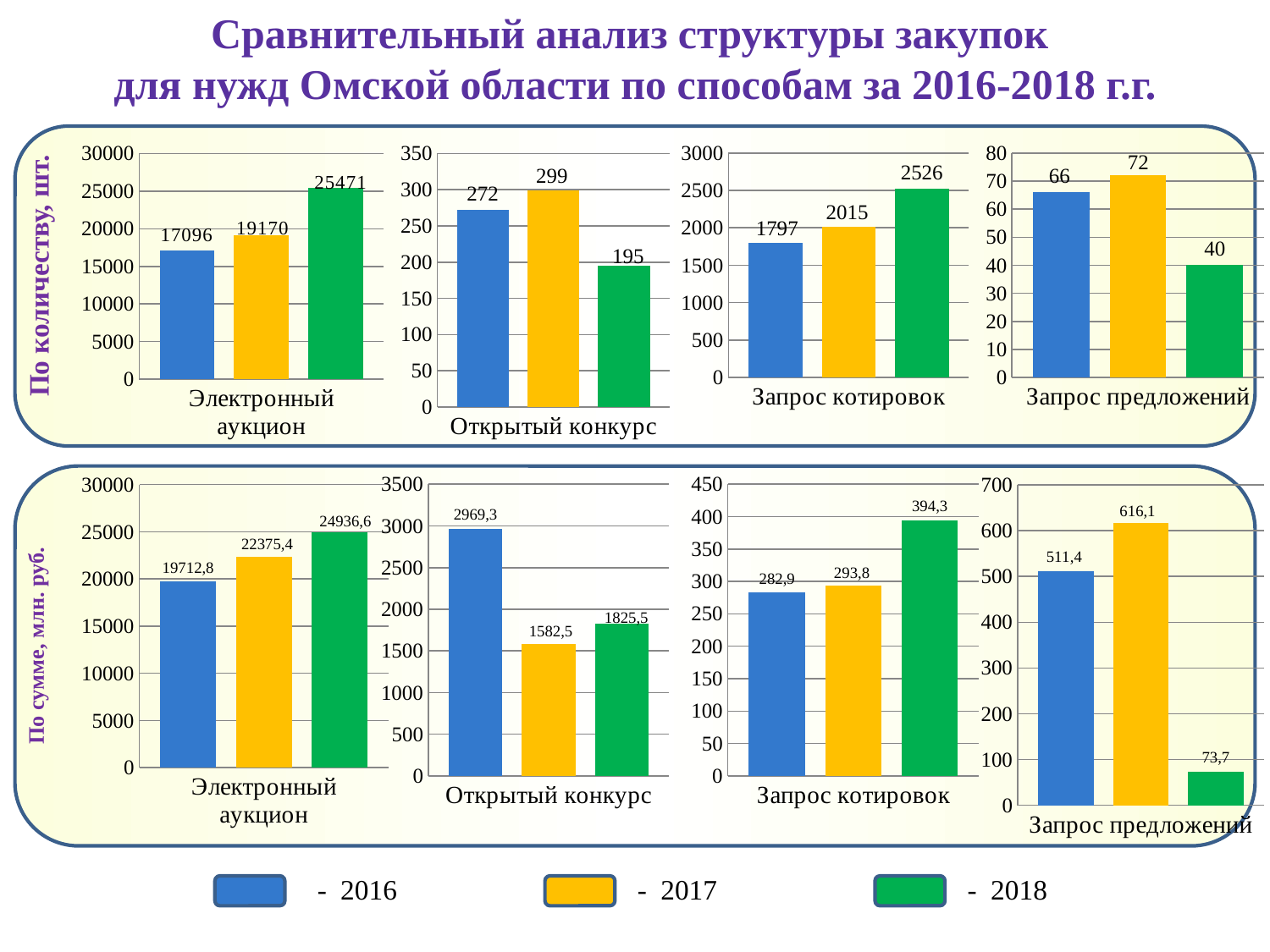
What kind of chart is used for Запрос котировок in the top row? bar chart Which colour represents 2017 in the legend? yellow In the top-row chart for Запрос котировок (По количеству, шт.), which year has the highest value? 2018 In the top-row chart for Открытый конкурс (По количеству, шт.), what is the value for 2017? 299 In the top-row chart for Запрос предложений (По количеству, шт.), which year has the lowest value? 2018 How many years does the legend at the bottom of the slide list? 3 In the top-row chart for Электронный аукцион (По количеству, шт.), what is the difference between the 2018 and 2016 values? 8375 In the bottom-row chart for Запрос котировок (По сумме, млн. руб.), which is larger: the 2017 value or the 2018 value? 2018 In the bottom-row chart for Открытый конкурс (По сумме, млн. руб.), what is the value for 2016? 2969,3 In the top-row chart for Электронный аукцион (По количеству, шт.), what is the value for 2018? 25471 In the bottom-row chart for Запрос предложений (По сумме, млн. руб.), what is the value for 2018? 73,7 In the bottom-row chart for Электронный аукцион (По сумме, млн. руб.), do the values rise or fall from 2016 to 2018? rise